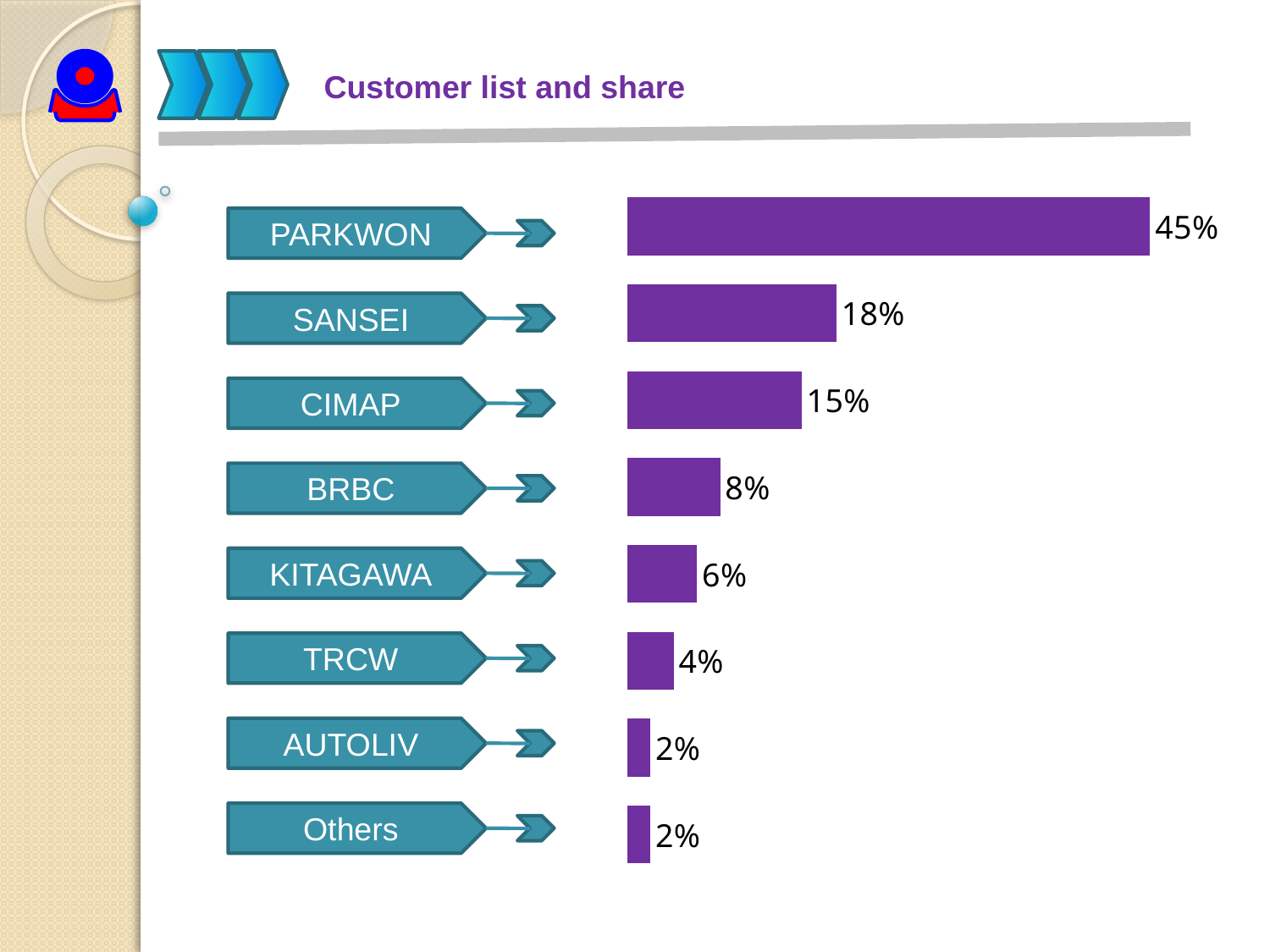
What kind of chart is shown on the slide? Bar chart What is the title of the slide containing the chart? Customer list and share Which has a larger share, KITAGAWA or TRCW? KITAGAWA What is the difference between the shares of PARKWON and SANSEI? 27% What is the share for KITAGAWA? 6% What is the difference between the shares of BRBC and TRCW? 4% What is the share for PARKWON? 45% What is the share for SANSEI? 18% How many customer categories are shown in the chart? 8 Which has a larger share, CIMAP or BRBC? CIMAP Which customer has the highest share? PARKWON What is the share for CIMAP? 15%